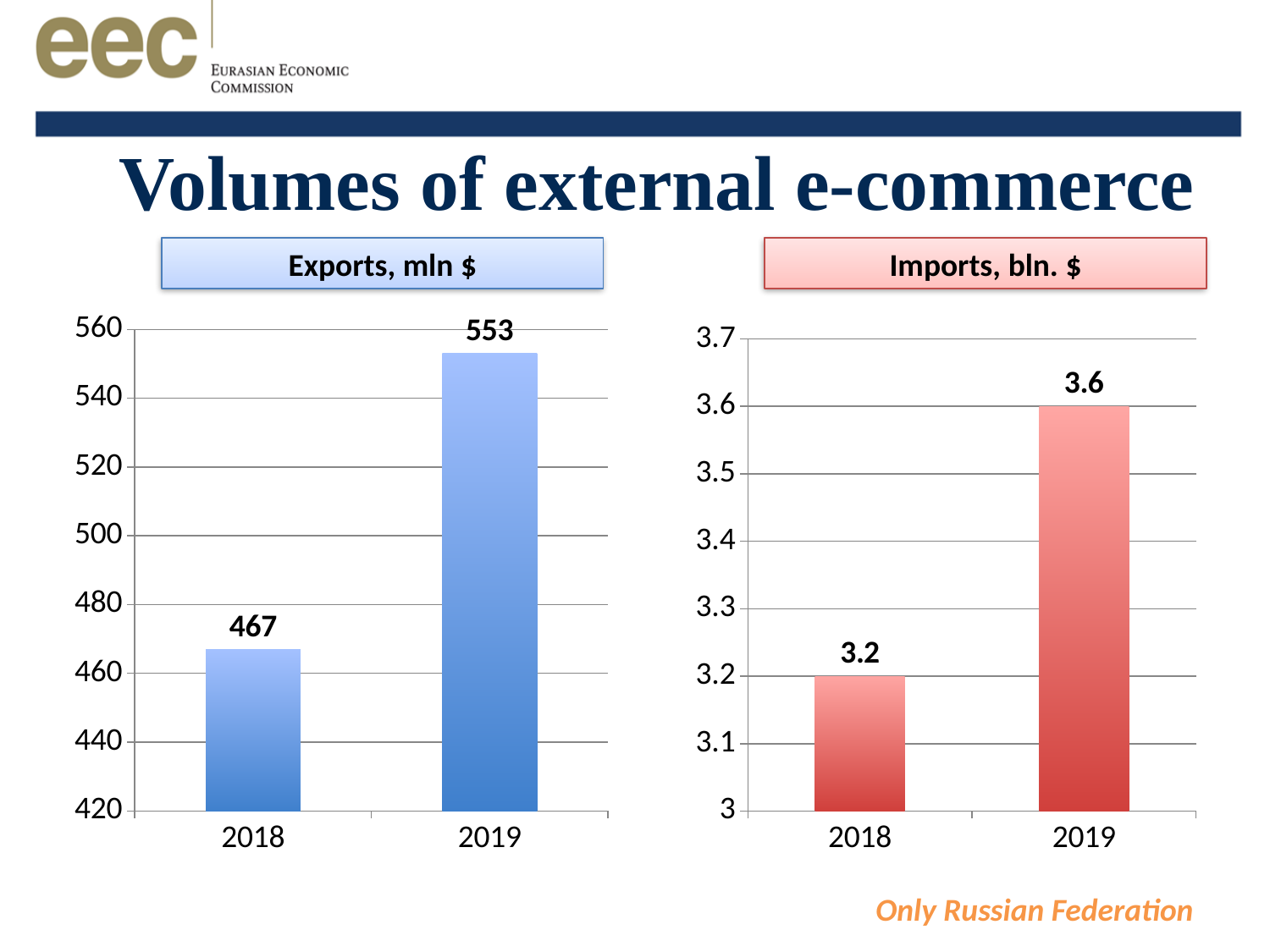
In the Exports, mln $ chart, what is the value for 2019? 553 In the Imports, bln. $ chart, is the value for 2019 greater or less than 3.5? greater In the Exports, mln $ chart, what is the difference between the 2019 and 2018 values? 86 In the Imports, bln. $ chart, what is the value for 2019? 3.6 What kind of chart is the Imports, bln. $ chart? bar chart In the Imports, bln. $ chart, which year has the lowest value? 2018 In the Exports, mln $ chart, do the values rise or fall from 2018 to 2019? rise In the Imports, bln. $ chart, what is the value for 2018? 3.2 In the Exports, mln $ chart, which year has the highest value? 2019 How many years are shown in the Exports, mln $ chart? 2 In the Imports, bln. $ chart, what is the difference between the 2019 and 2018 values? 0.4 In the Exports, mln $ chart, what is the value for 2018? 467